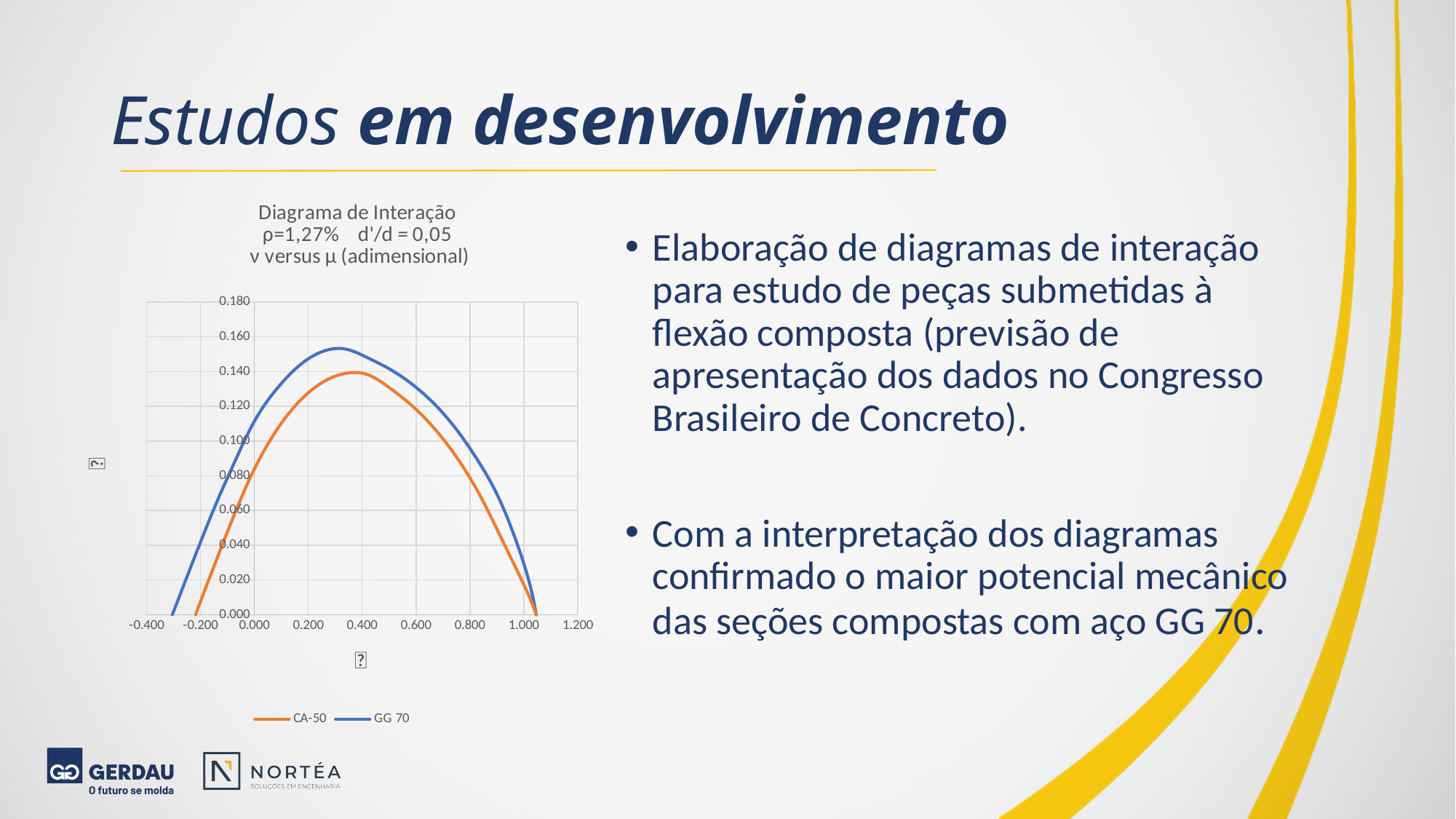
Is the peak value of the CA-50 curve greater or less than 0.160? less Which series reaches the higher peak value on the vertical axis, CA-50 or GG 70? GG 70 Moving from left to right along the x axis, do the curves rise and then fall, or fall and then rise? rise and then fall What is the highest tick value shown on the vertical axis of the chart? 0.180 What is the lowest tick value shown on the horizontal axis of the chart? -0.400 What are the two series named in the chart legend? CA-50 and GG 70 Is the peak value of the GG 70 curve greater or less than 0.140? greater What kind of chart is shown on the slide? line chart Which colour is used for the GG 70 series in the chart? blue How many series does the legend of the chart list? 2 Which curve crosses the horizontal axis at the more negative x value on the left side, CA-50 or GG 70? GG 70 Is the peak value of the CA-50 curve greater or less than 0.120? greater